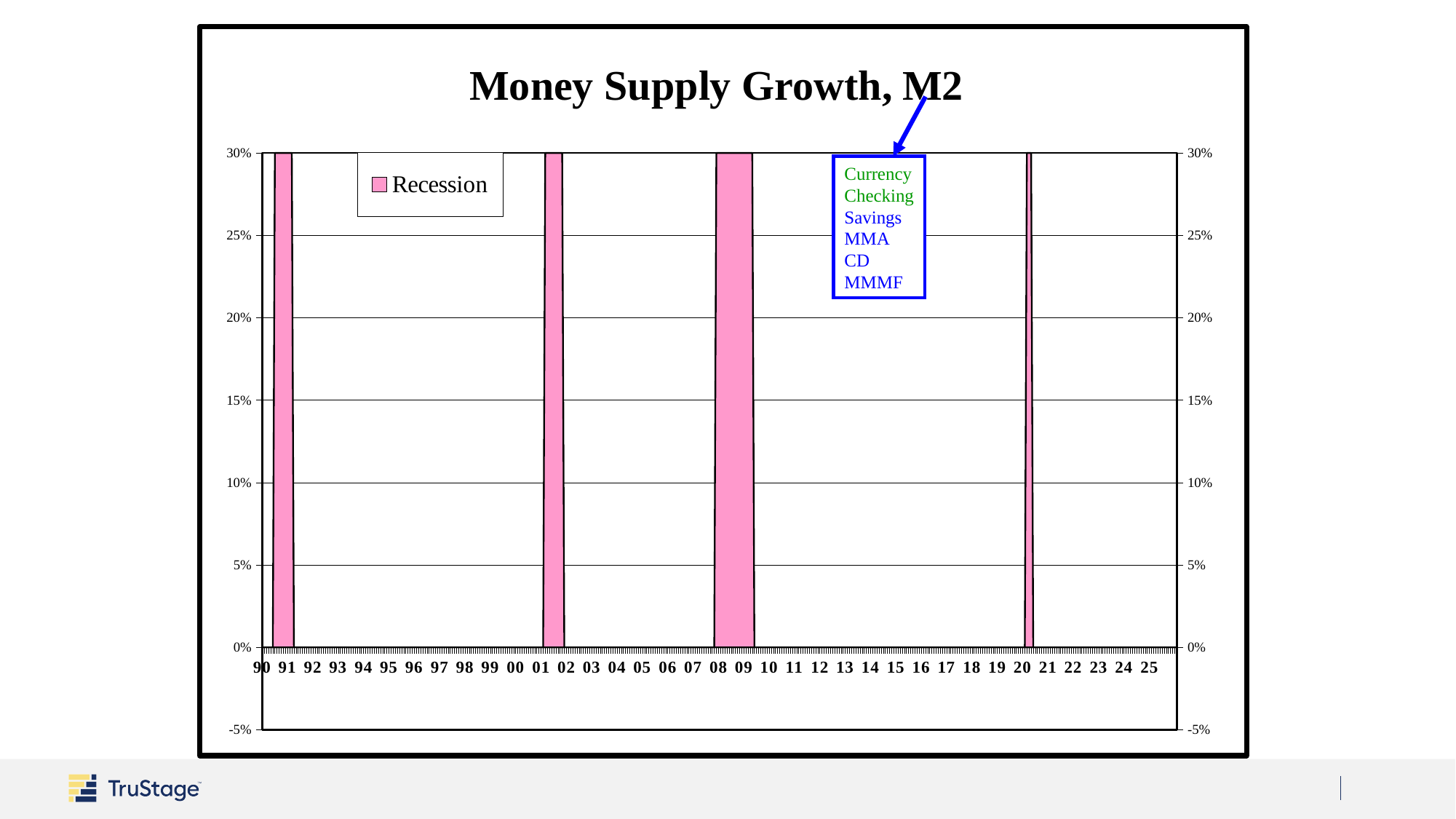
What is the first year label on the x axis? 90 Which recession bar is the widest: the one around 01-02 or the one around 08-09? 08-09 What kind of chart is shown on the slide? bar chart What is the name of the series shown in the legend? Recession What value on the y axis do the recession bars reach? 30% How many shaded recession bars are plotted on the chart? 4 Is the recession bar around 91 greater or less than 25%? greater What is the highest value shown on the y axis? 30% Which items are listed in the blue box pointed to by the arrow? Currency, Checking, Savings, MMA, CD, MMMF What is the lowest value shown on the y axis? -5% What is the title of the chart? Money Supply Growth, M2 How many entries does the chart's legend list? 1